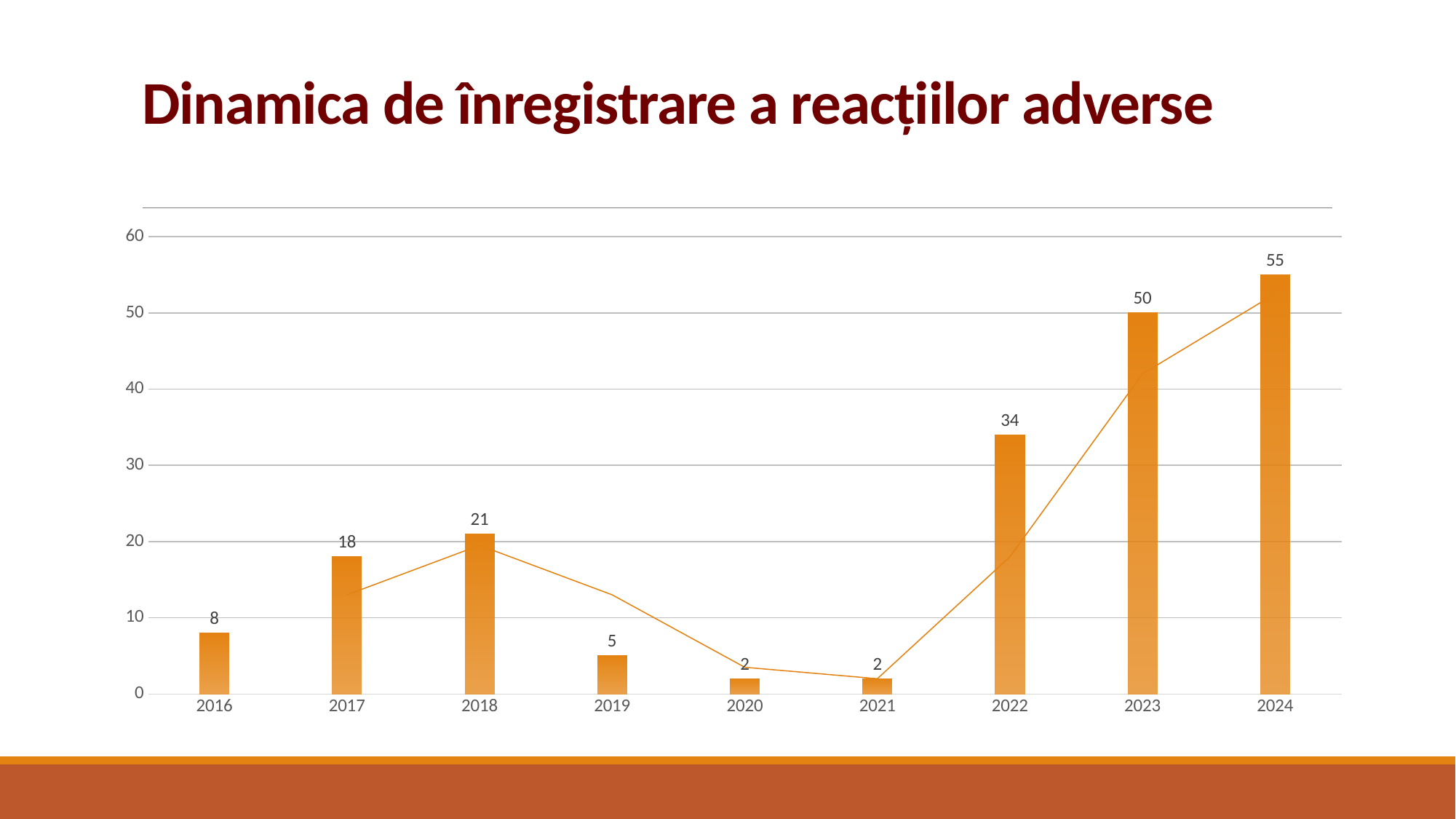
What is the value for 2022? 34 How many years are shown on the x axis? 9 What kind of chart is this? bar chart with a line Is the value for 2023 greater or less than 40? greater Do the values rise or fall from 2021 to 2024? rise Which year has the lowest value? 2020 and 2021 What is the difference between the values for 2024 and 2023? 5 Which year has the highest value? 2024 What is the value for 2016? 8 Which is larger, the value for 2017 or the value for 2018? 2018 What is the value for 2018? 21 What is the difference between the values for 2022 and 2019? 29